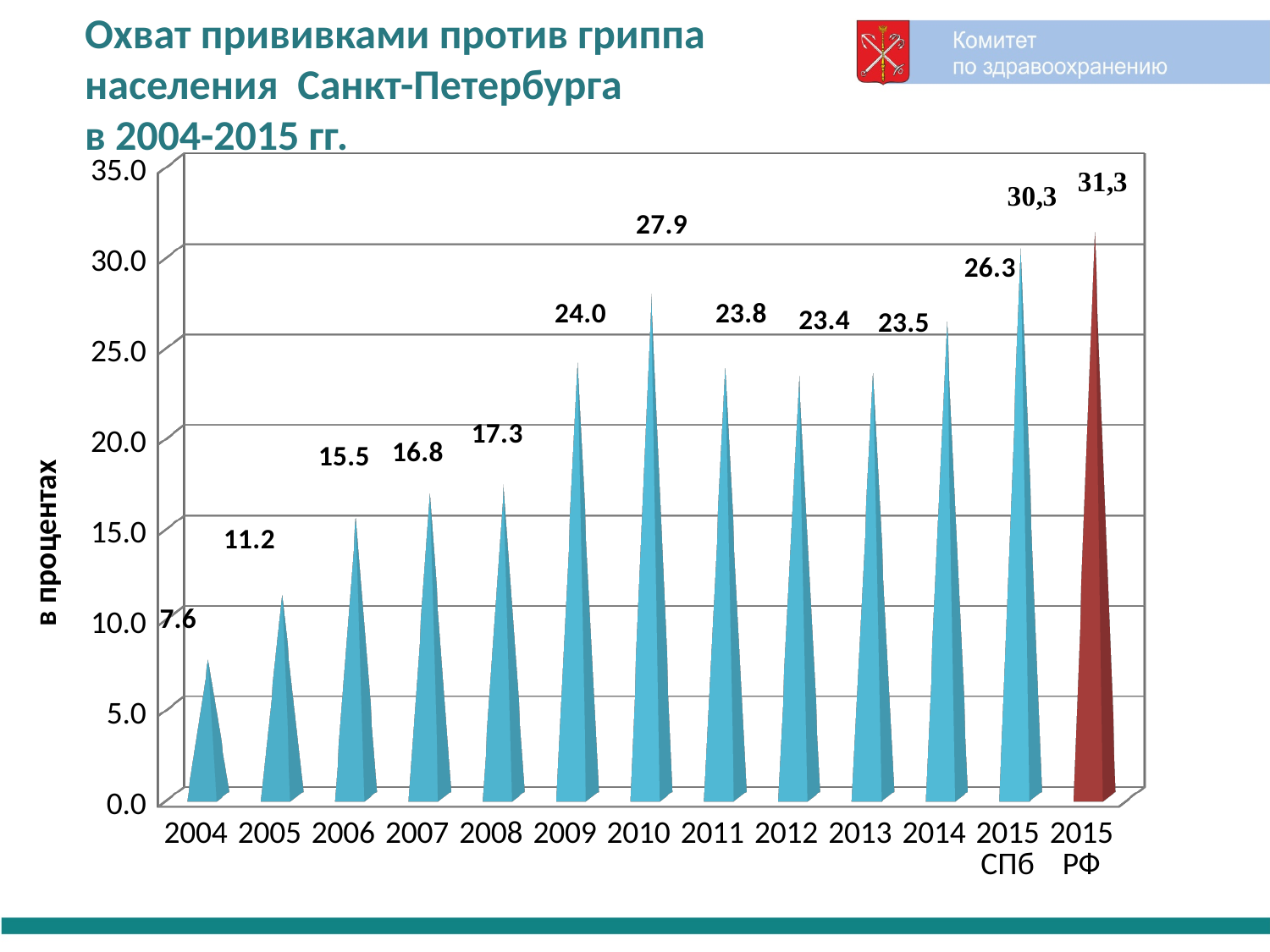
What is the value for 2015 РФ? 31,3 What is the difference between the values for 2010 and 2009? 3.9 What kind of chart is this? bar chart What is the value for 2015 СПб? 30,3 What is the value for 2004? 7.6 Do the values rise or fall from 2004 to 2010? rise Which is larger, the value for 2011 or the value for 2012? 2011 Is the value for 2014 greater or less than 25.0? greater Which category has the highest value? 2015 РФ Which category has the lowest value? 2004 What is the value for 2010? 27.9 How many categories are shown on the x axis? 13